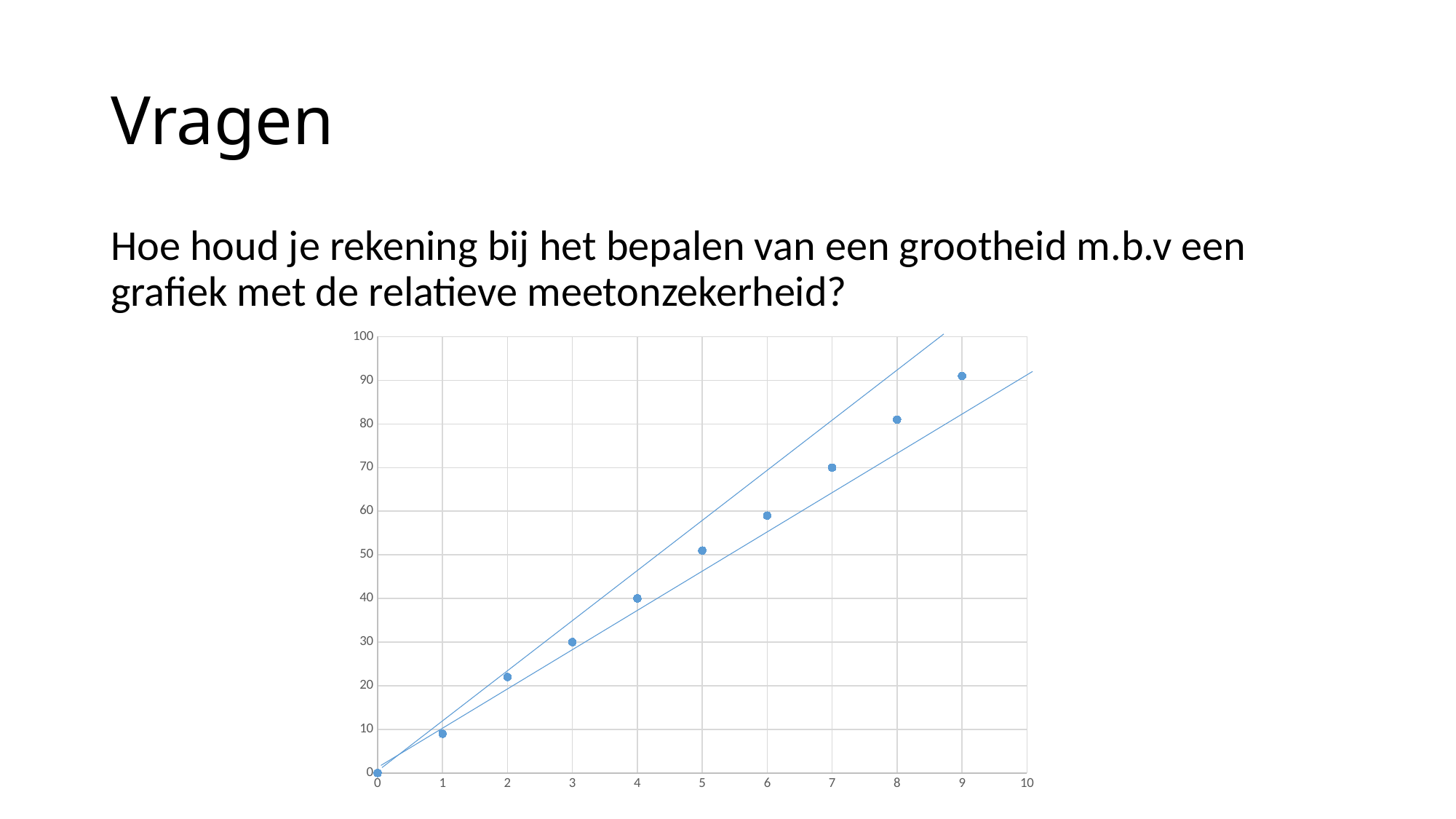
Is the y value of the point at x = 6 greater or less than 50? greater Which point has a larger y value, the one at x = 2 or the one at x = 5? x = 5 Is the y value of the point at x = 8 greater or less than 90? less What is the y value of the point at x = 7? 70 At which x value is the plotted point lowest? 0 Do the plotted values rise or fall as x increases from 0 to 9? rise What kind of chart is shown on the slide? scatter chart What is the y value of the point at x = 4? 40 How many data points are plotted on the chart? 10 At which x value is the plotted point highest? 9 Is the y value of the point at x = 9 greater or less than 80? greater